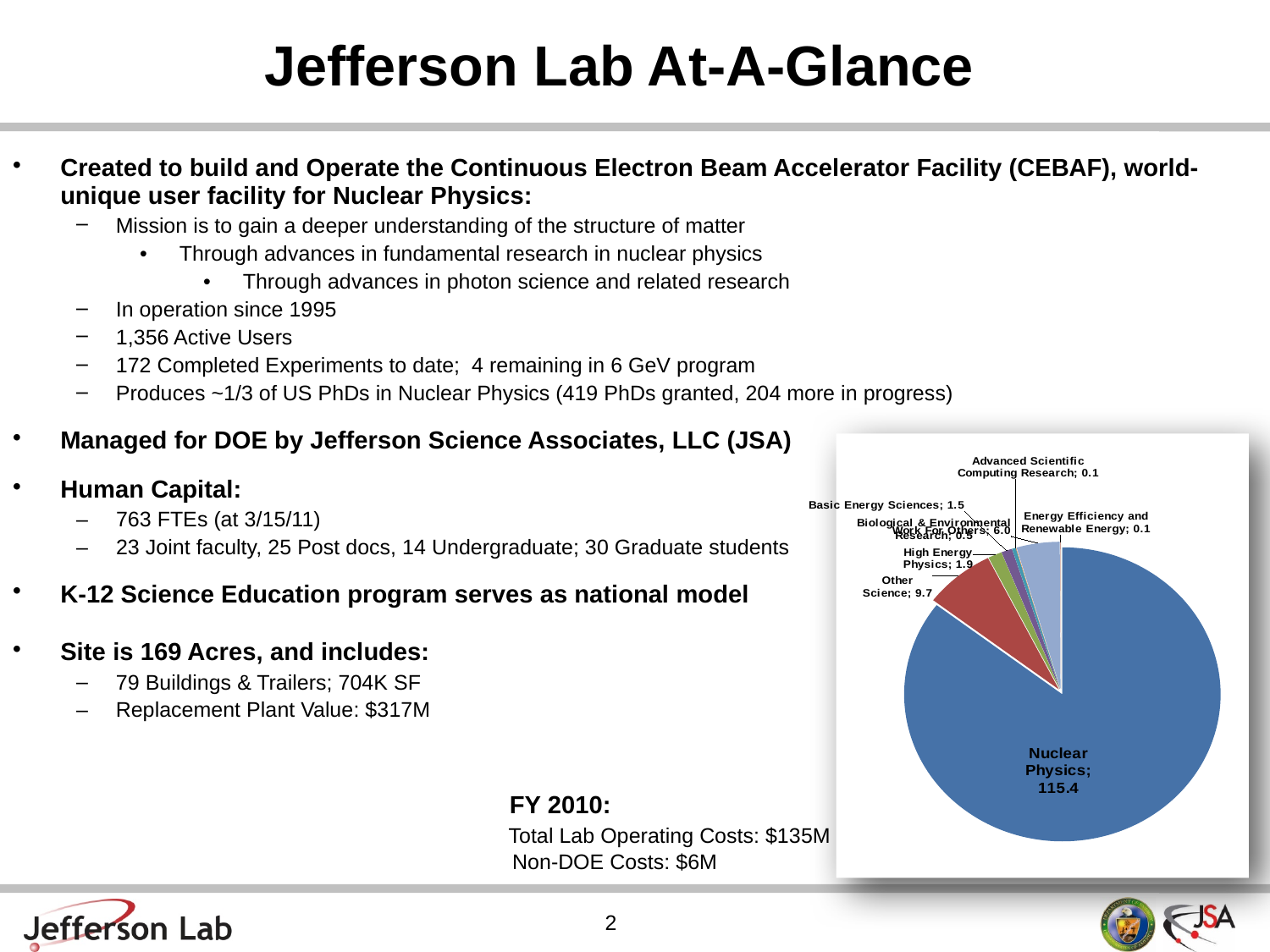
What is the value for Basic Energy Sciences in the pie chart? 1.5 What is the value for Advanced Scientific Computing Research in the pie chart? 0.1 Which category has the largest slice in the pie chart? Nuclear Physics Which is larger in the pie chart, Work For Others or High Energy Physics? Work For Others What colour is the Nuclear Physics slice in the pie chart? blue What is the value for Nuclear Physics in the pie chart? 115.4 What is the value for High Energy Physics in the pie chart? 1.9 What type of chart is shown on the slide? pie chart How many slices does the pie chart have? 8 What is the difference between the Nuclear Physics value and the Other Science value in the pie chart? 105.7 What is the value for Work For Others in the pie chart? 6.0 What is the value for Other Science in the pie chart? 9.7